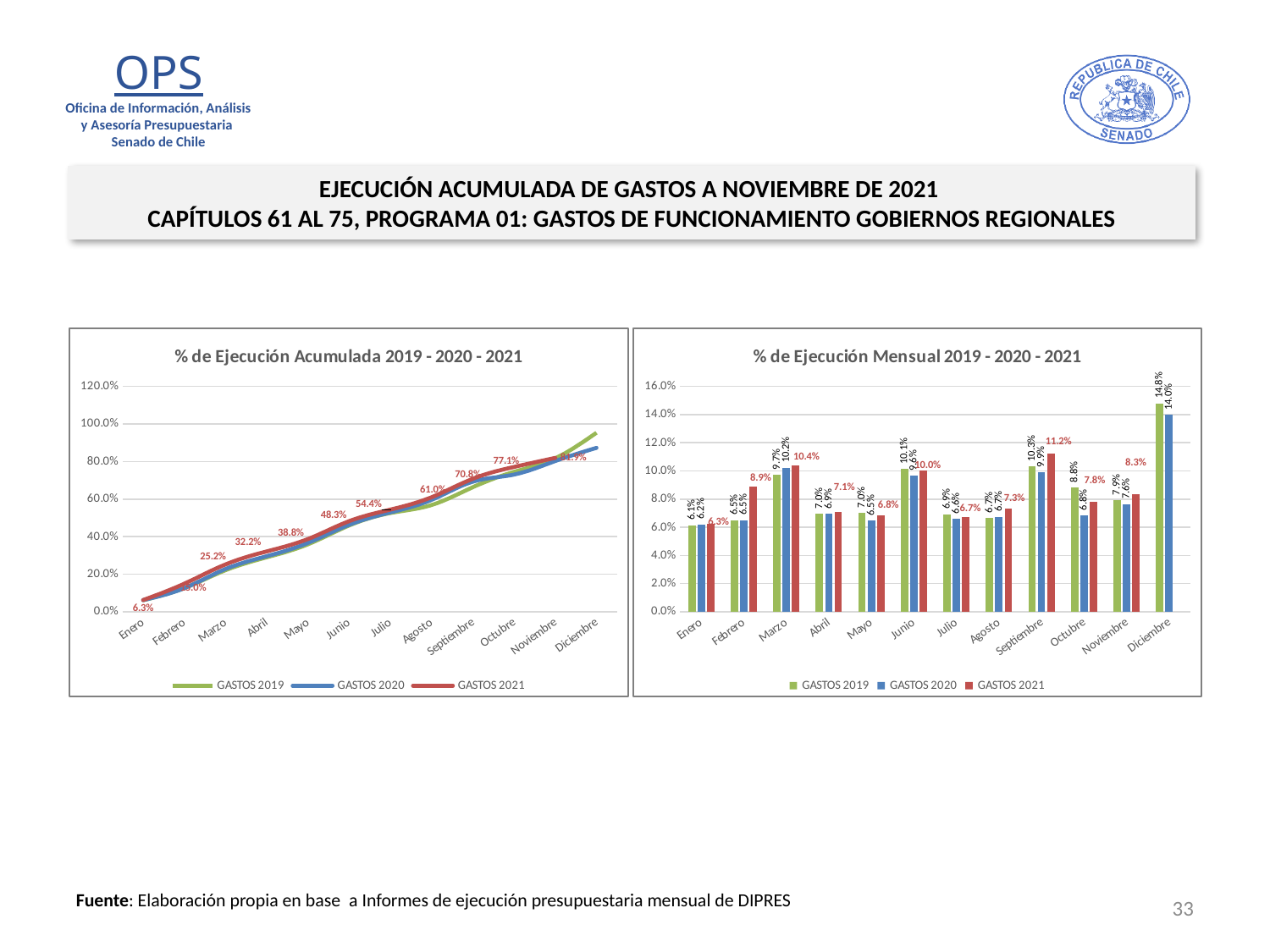
What kind of chart is the '% de Ejecución Mensual 2019 - 2020 - 2021' chart on the right? Bar chart In the '% de Ejecución Mensual 2019 - 2020 - 2021' chart, which month has the lowest value for GASTOS 2020? Enero How many series does the legend of the '% de Ejecución Acumulada 2019 - 2020 - 2021' chart list? 3 In the '% de Ejecución Mensual 2019 - 2020 - 2021' chart, what is the value for GASTOS 2021 in Septiembre? 11.2% In the '% de Ejecución Acumulada 2019 - 2020 - 2021' chart, do the GASTOS 2021 values rise or fall from Enero to Noviembre? Rise In the '% de Ejecución Mensual 2019 - 2020 - 2021' chart, which is larger in Marzo: GASTOS 2019 or GASTOS 2021? GASTOS 2021 In the '% de Ejecución Mensual 2019 - 2020 - 2021' chart, what is the value for GASTOS 2019 in Diciembre? 14.8% In the '% de Ejecución Mensual 2019 - 2020 - 2021' chart, which month has the highest value for GASTOS 2021? Septiembre In the '% de Ejecución Mensual 2019 - 2020 - 2021' chart, what is the difference between GASTOS 2021 and GASTOS 2020 in Septiembre? 1.3 percentage points How many months are shown on the x axis of the '% de Ejecución Acumulada 2019 - 2020 - 2021' chart? 12 In the '% de Ejecución Acumulada 2019 - 2020 - 2021' chart, is the value for GASTOS 2019 in Diciembre greater or less than 80.0%? greater In the '% de Ejecución Acumulada 2019 - 2020 - 2021' chart, what is the value for GASTOS 2021 in Octubre? 77.1%